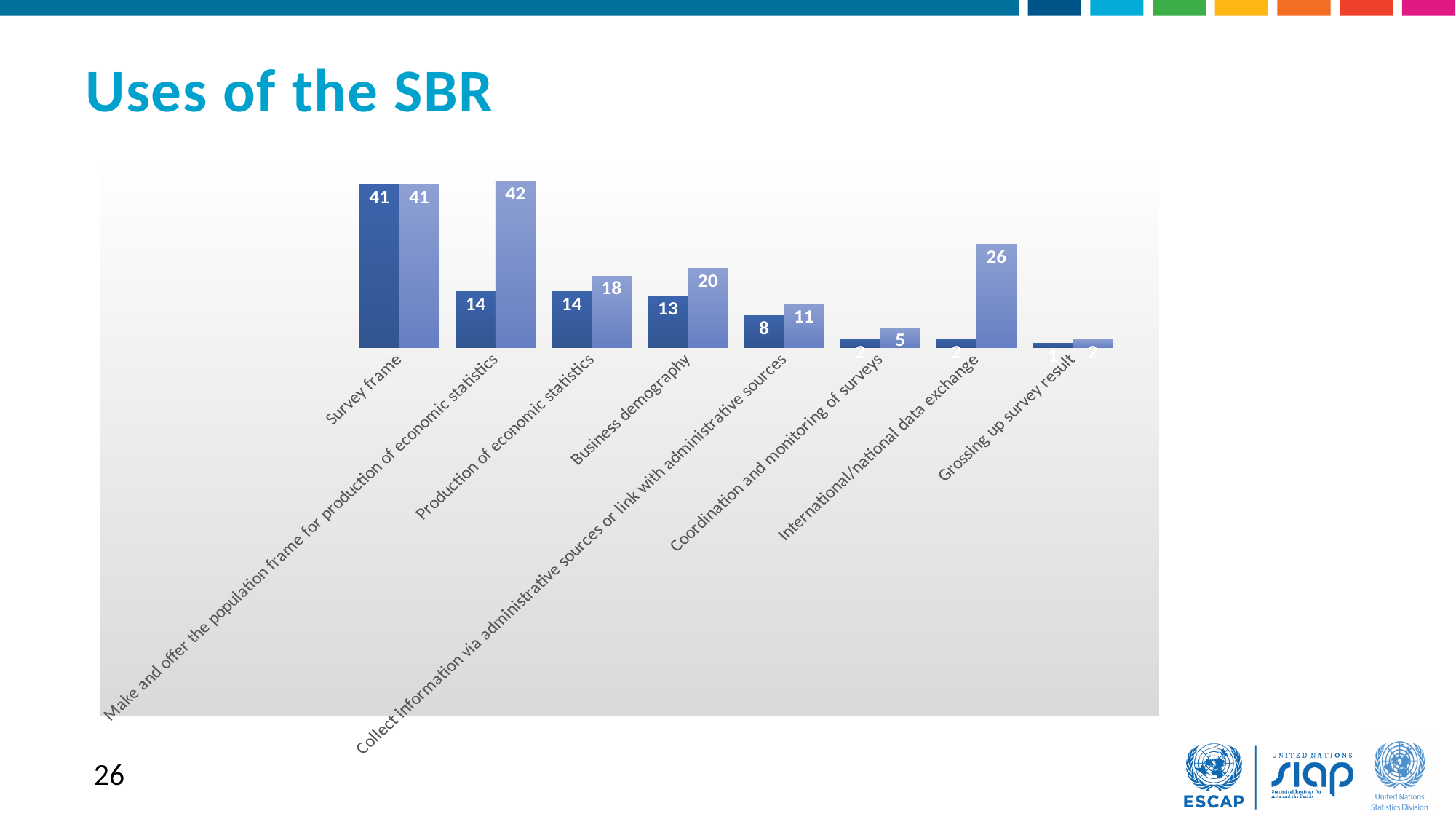
Which category has the lowest dark blue bar? Grossing up survey result What is the value of the dark blue bar for Business demography? 13 What is the value of the light blue bar for Make and offer the population frame for production of economic statistics? 42 Which is larger for Production of economic statistics, the dark blue bar or the light blue bar? the light blue bar How many categories are shown on the x axis of the chart? 8 What is the title of the slide containing the chart? Uses of the SBR What is the difference between the light blue and dark blue bars for Business demography? 7 What is the difference between the light blue and dark blue bars for International/national data exchange? 24 What is the value of the dark blue bar for Survey frame? 41 Which category has the highest light blue bar? Make and offer the population frame for production of economic statistics What kind of chart is shown on the slide? bar chart What is the value of the light blue bar for International/national data exchange? 26